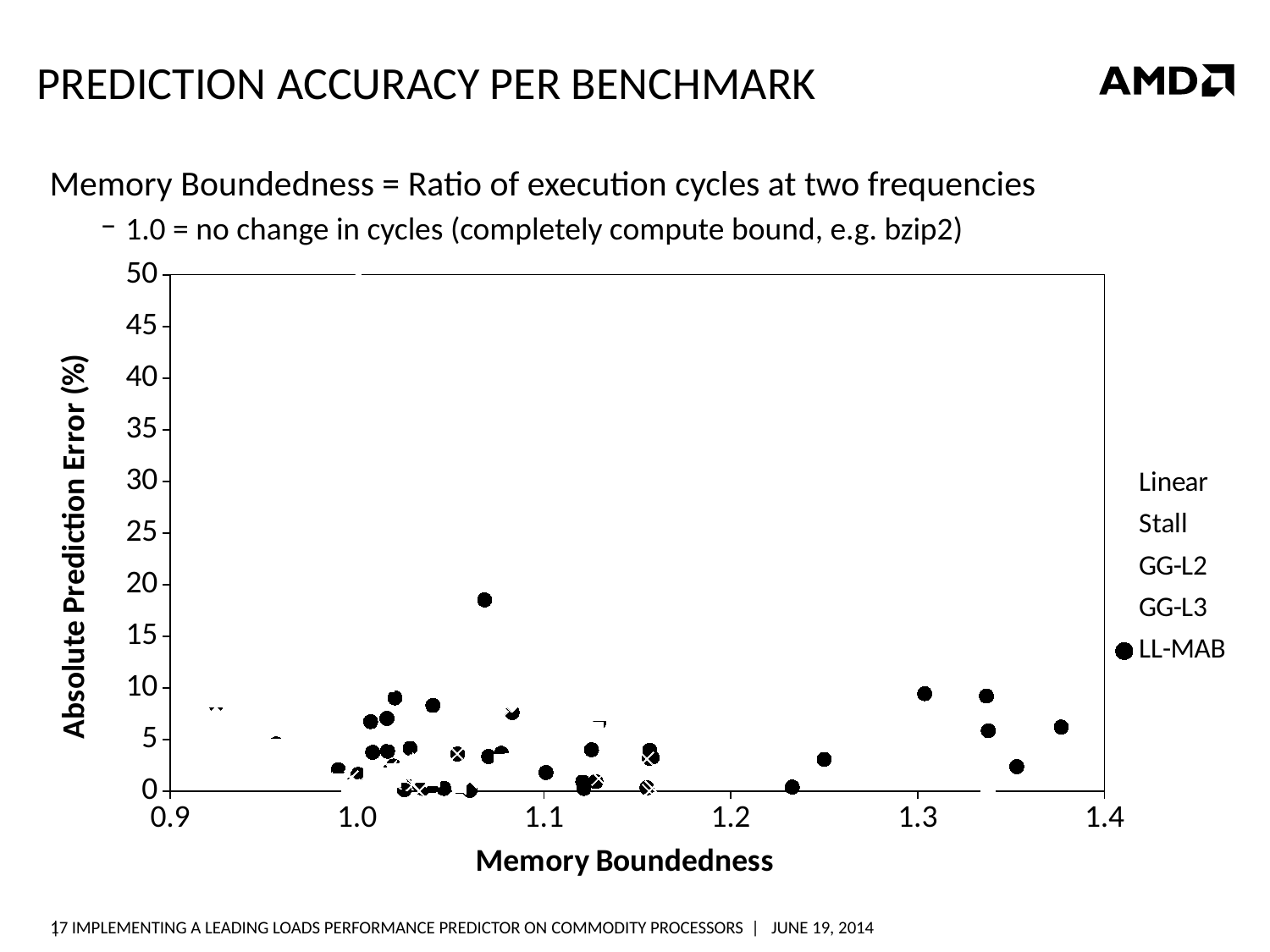
How many series does the chart legend list? 5 What is the title of the x axis of the chart? Memory Boundedness Which series is shown with solid black circle markers in the legend? LL-MAB Is the LL-MAB point at a Memory Boundedness of about 1.25 greater or less than 5 on the Absolute Prediction Error axis? less Is the LL-MAB point at a Memory Boundedness of about 1.3 greater or less than 5 on the Absolute Prediction Error axis? greater What kind of chart is shown on the slide? Scatter chart Is the LL-MAB point near a Memory Boundedness of 1.07 greater or less than 10 on the Absolute Prediction Error axis? greater